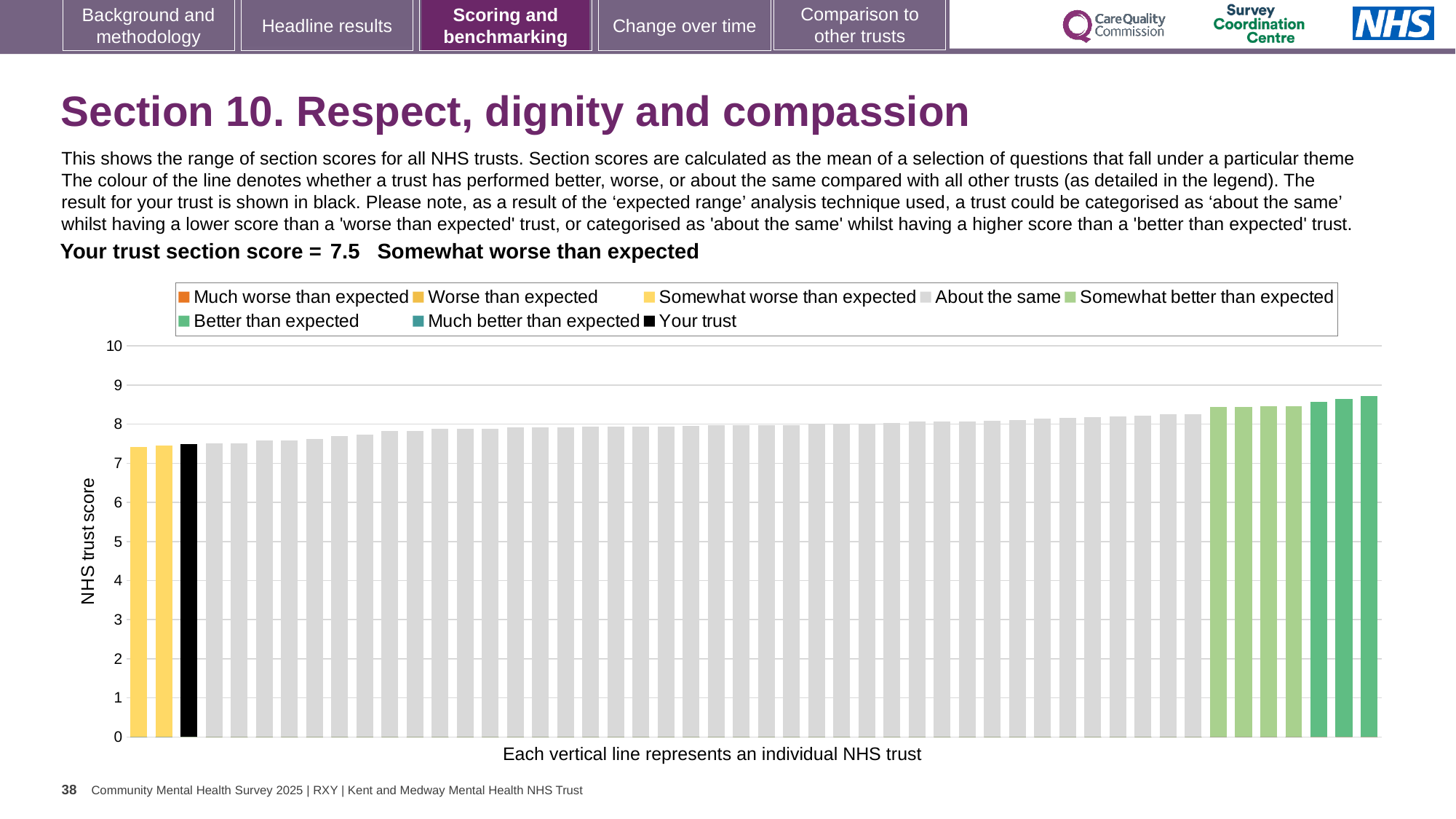
How many bars are coloured yellow (Somewhat worse than expected)? 2 Is the value for your trust (the black bar) greater or less than 7? greater Do the bar values rise or fall from left to right along the x axis? Rise Is the highest bar in the chart greater or less than 9? less What is the section score for your trust shown on the slide? 7.5 How many entries does the chart legend list? 8 Which performance category is your trust placed in for Section 10? Somewhat worse than expected What colour is used for the bar representing your trust? Black How many bars are in the darker green 'Better than expected' colour at the right of the chart? 3 What kind of chart is shown on the slide? Bar chart What is the label on the vertical axis of the chart? NHS trust score Is the lowest bar in the chart greater or less than 7? greater